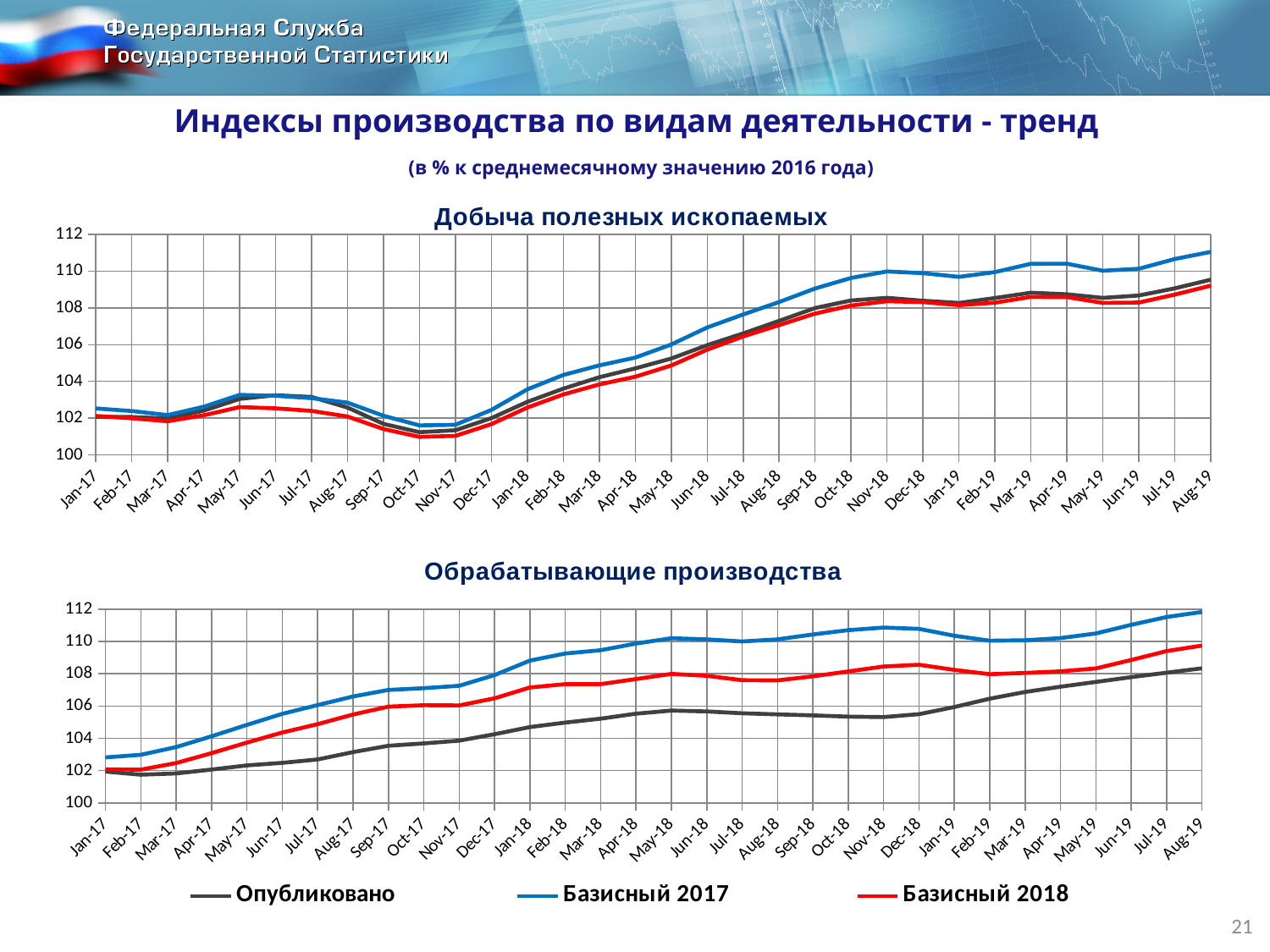
What kind of chart is the top chart titled "Добыча полезных ископаемых"? line chart In the bottom chart "Обрабатывающие производства", is the value of Базисный 2018 at Aug-19 greater or less than 108? greater In the top chart "Добыча полезных ископаемых", which series is higher at Jan-18: Базисный 2017 or Базисный 2018? Базисный 2017 In the bottom chart "Обрабатывающие производства", which series is higher at Aug-19: Базисный 2017 or Опубликовано? Базисный 2017 In the bottom chart "Обрабатывающие производства", how many monthly points are shown on the x axis from Jan-17 to Aug-19? 32 In the top chart "Добыча полезных ископаемых", is the value of Опубликовано at Oct-17 greater or less than 102? less What colour is the line for Базисный 2018 in the legend? red How many series does the legend at the bottom of the slide list? 3 In the bottom chart "Обрабатывающие производства", which series has the highest value at Nov-18? Базисный 2017 In the bottom chart "Обрабатывающие производства", is the value of Опубликовано at Jan-17 greater or less than 104? less In the bottom chart "Обрабатывающие производства", does the Базисный 2017 series generally rise or fall from Jan-17 to Aug-19? rise